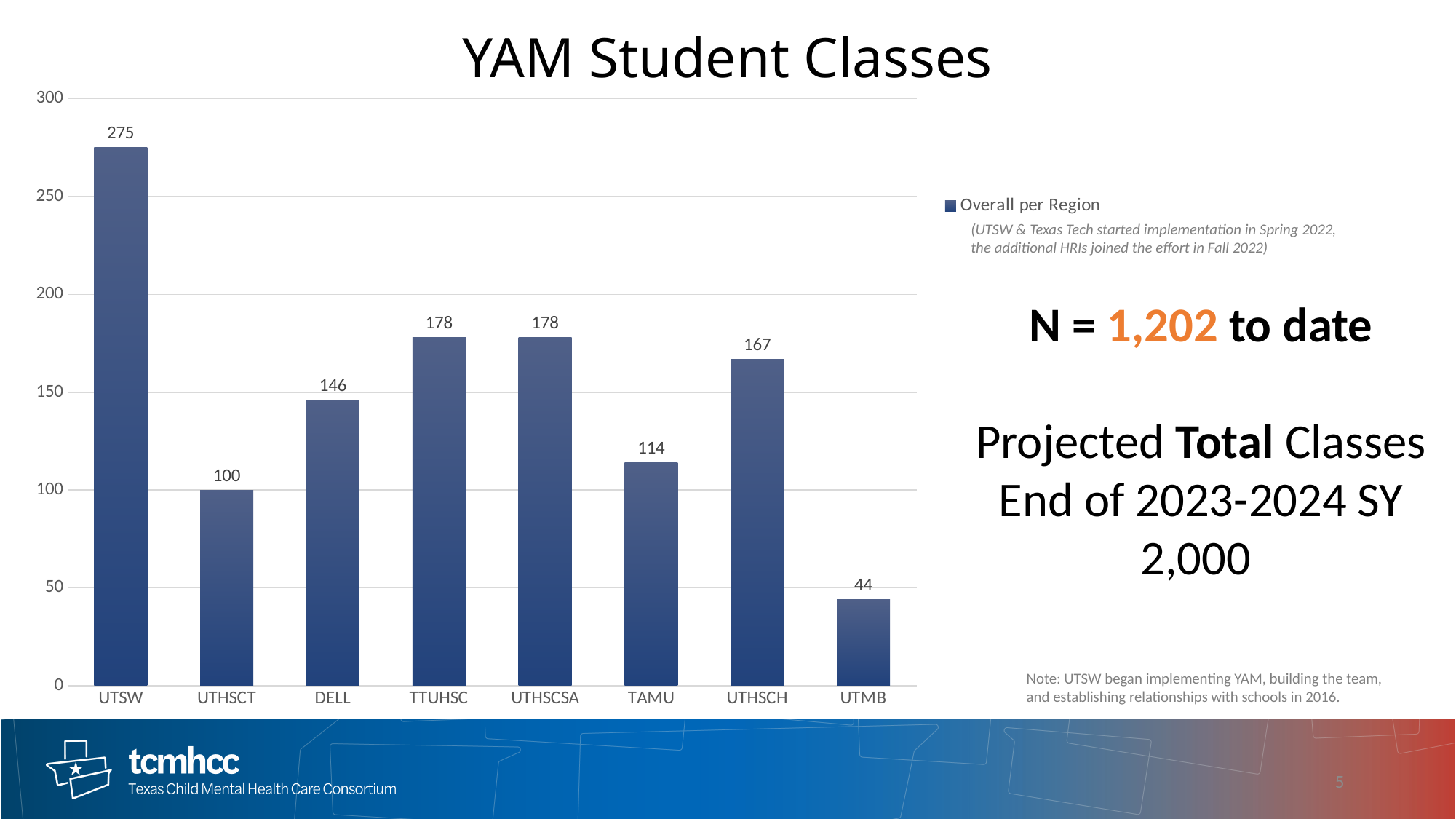
What kind of chart is shown on the slide? bar chart Which region has the highest number of YAM student classes? UTSW Which region has the lowest number of YAM student classes? UTMB Is the value for UTHSCSA greater or less than 150? greater What is the legend entry for the series shown in the chart? Overall per Region What is the difference between the values for UTSW and UTHSCT? 175 Which is larger, the value for DELL or the value for TAMU? DELL What is the difference between the values for DELL and UTMB? 102 What is the value for UTHSCH? 167 What is the value for UTSW? 275 How many regions are shown on the x axis? 8 What is the value for TAMU? 114